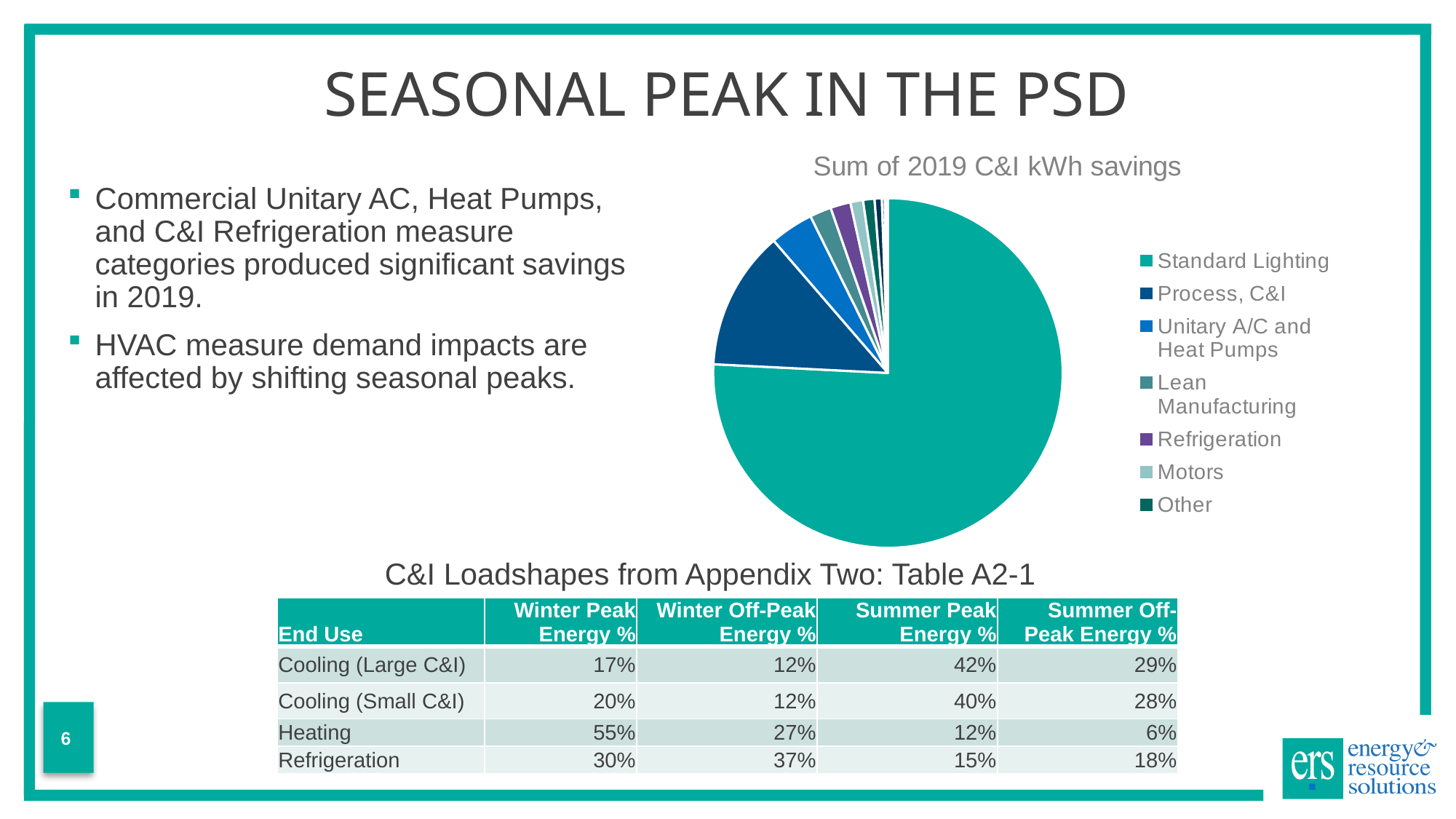
What kind of chart is shown on the slide? pie chart What is the title of the pie chart? Sum of 2019 C&I kWh savings Which category is listed first in the pie chart's legend? Standard Lighting Which is larger in the pie chart, the slice for Standard Lighting or the slice for Process, C&I? Standard Lighting How many categories does the pie chart's legend list? 7 Which is larger in the pie chart, the slice for Process, C&I or the slice for Unitary A/C and Heat Pumps? Process, C&I Which category has the largest slice in the pie chart? Standard Lighting Which category is listed last in the pie chart's legend? Other Which is larger in the pie chart, the slice for Unitary A/C and Heat Pumps or the slice for Refrigeration? Unitary A/C and Heat Pumps